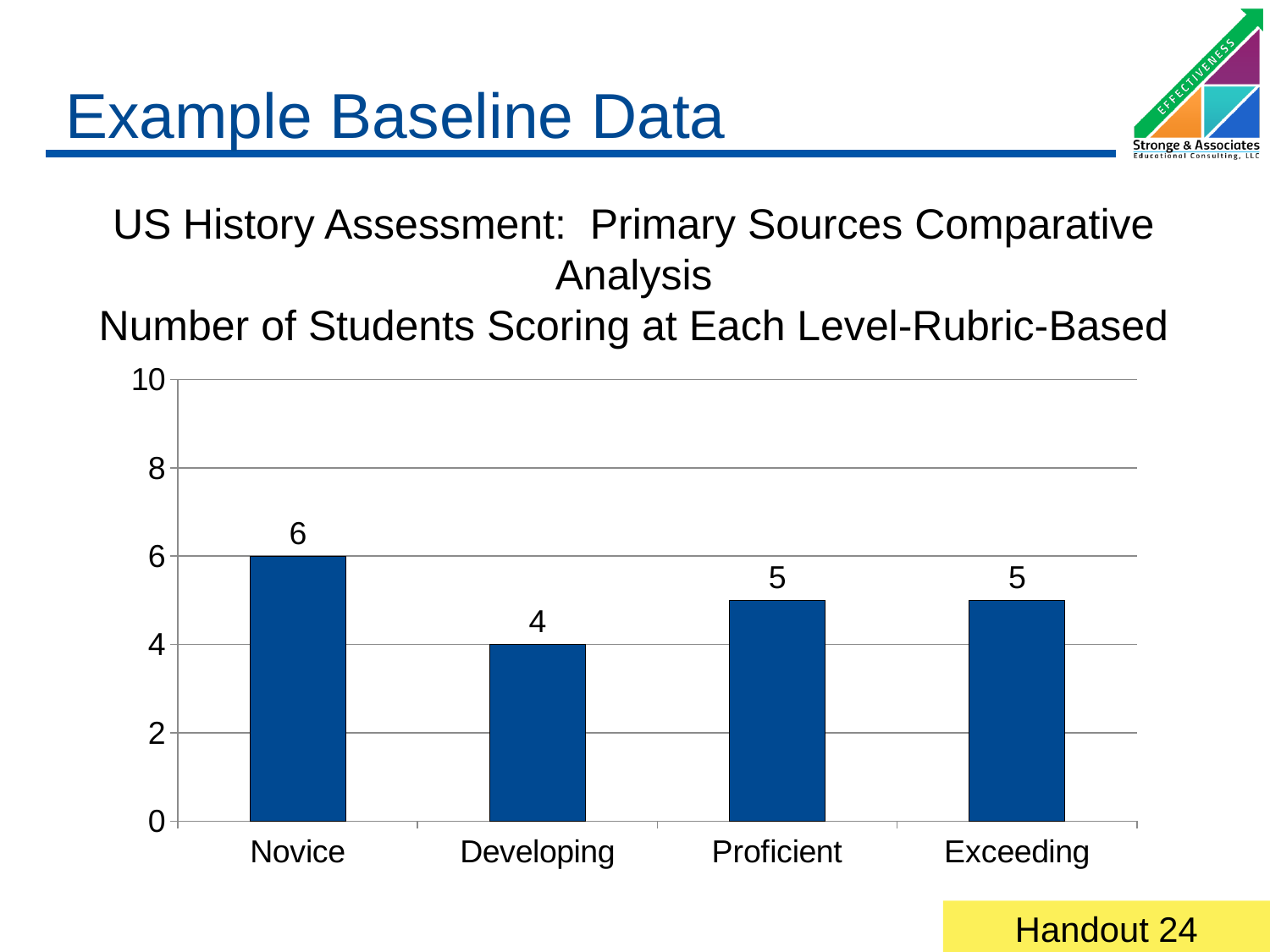
How many students scored at the Novice level? 6 What is the total number of students across all four levels? 20 How many students scored at the Proficient level? 5 Which has more students, Novice or Proficient? Novice Is the value for Developing greater or less than 6? less How many students scored at the Exceeding level? 5 Which level has the highest number of students? Novice Which level has the lowest number of students? Developing How many students scored at the Developing level? 4 How many levels are shown on the x axis? 4 What kind of chart is shown on the slide? Bar chart What is the difference between the number of students at Novice and at Developing? 2